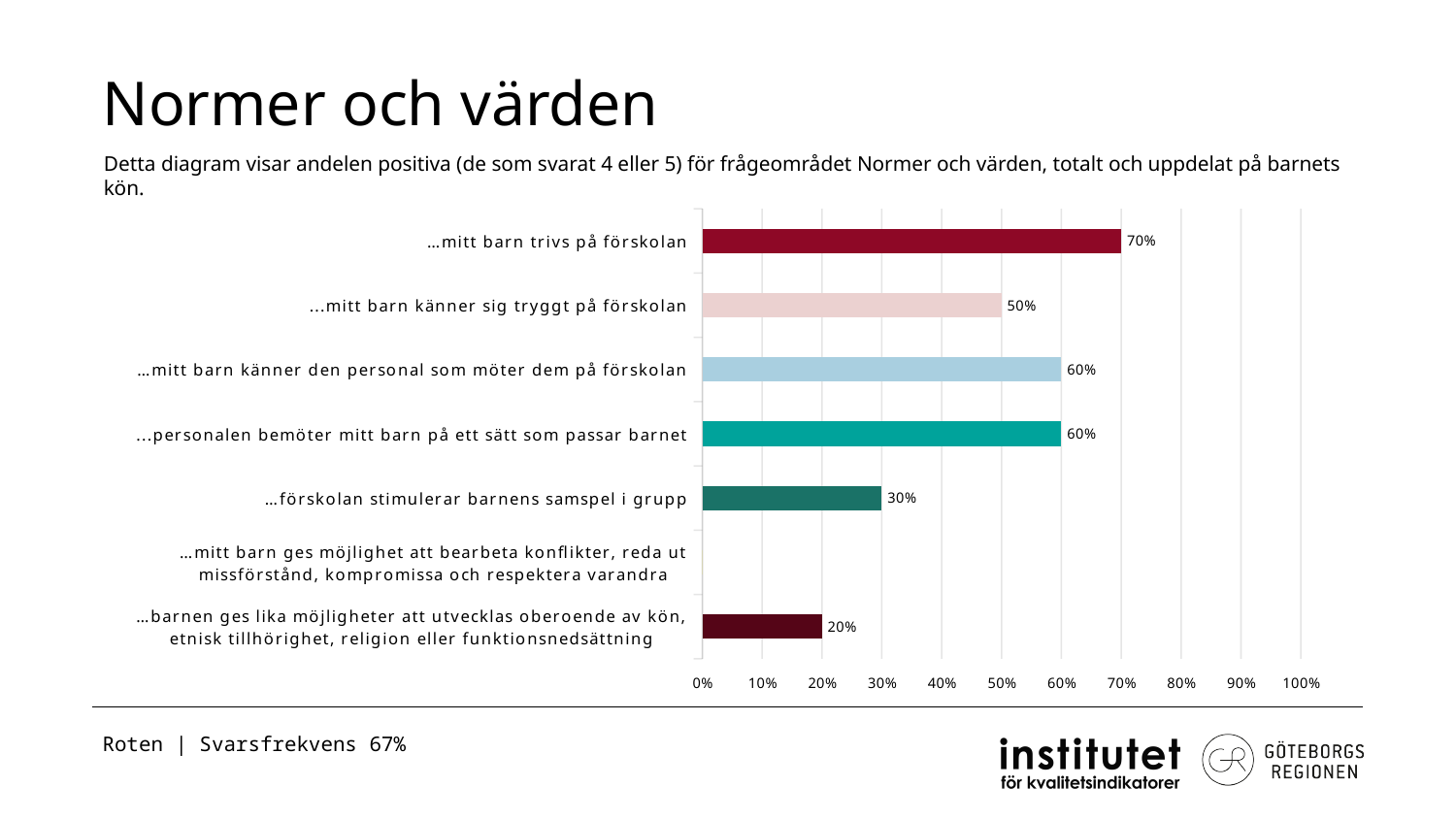
Which category has the highest value? …mitt barn trivs på förskolan Among the categories with a plotted bar, which has the lowest value? …barnen ges lika möjligheter att utvecklas oberoende av kön, etnisk tillhörighet, religion eller funktionsnedsättning What is the value for "...mitt barn känner sig tryggt på förskolan"? 50% How many category labels are listed on the vertical axis of the chart? 7 Which is larger: the value for "…mitt barn känner den personal som möter dem på förskolan" or the value for "…förskolan stimulerar barnens samspel i grupp"? …mitt barn känner den personal som möter dem på förskolan What is the difference between the values for "…mitt barn trivs på förskolan" and "...mitt barn känner sig tryggt på förskolan"? 20% Is the value for "...personalen bemöter mitt barn på ett sätt som passar barnet" greater or less than 50%? greater What is the value for "…förskolan stimulerar barnens samspel i grupp"? 30% Which category has no bar plotted in the chart? …mitt barn ges möjlighet att bearbeta konflikter, reda ut missförstånd, kompromissa och respektera varandra What is the value for "…mitt barn trivs på förskolan"? 70% What kind of chart is shown on the slide? Bar chart What is the value for "…barnen ges lika möjligheter att utvecklas oberoende av kön, etnisk tillhörighet, religion eller funktionsnedsättning"? 20%